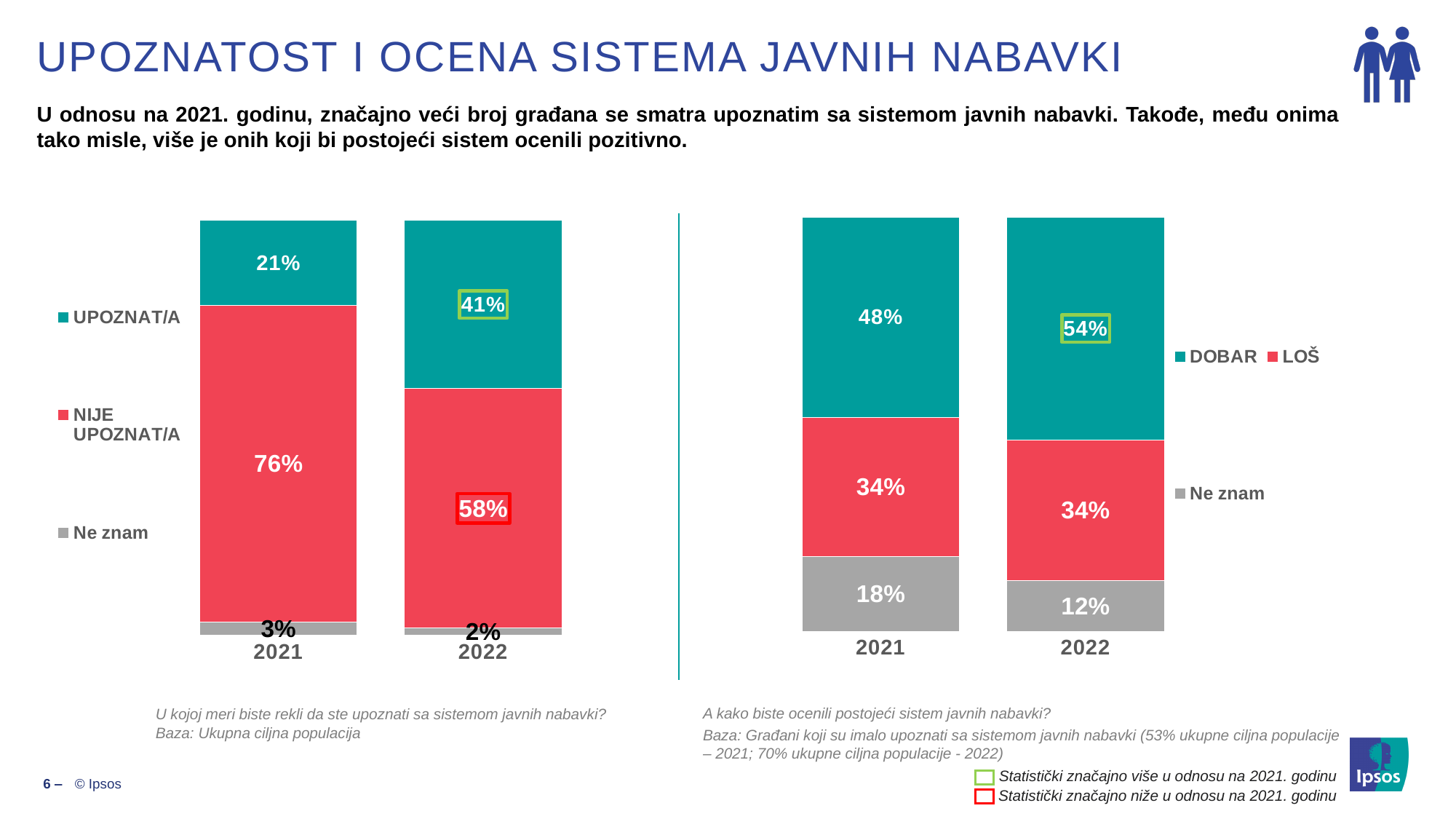
In the right chart, what is the value for DOBAR in 2021? 48% In the right chart, does the DOBAR value rise or fall from 2021 to 2022? rise In the left chart, what is the value for UPOZNAT/A in 2022? 41% In the left chart, which segment is the smallest in 2021? Ne znam In the left chart, which is larger in 2022: UPOZNAT/A or NIJE UPOZNAT/A? NIJE UPOZNAT/A How many series does the legend of the right chart list? 3 What type of chart is the left chart? stacked bar chart In the left chart, by how many percentage points did UPOZNAT/A change from 2021 to 2022? 20 percentage points In the right chart, which is larger in 2022: DOBAR or LOŠ? DOBAR In the left chart, what is the value for NIJE UPOZNAT/A in 2021? 76% In the right chart, what is the value for Ne znam in 2022? 12% In the right chart, what is the difference between DOBAR in 2022 and DOBAR in 2021? 6 percentage points